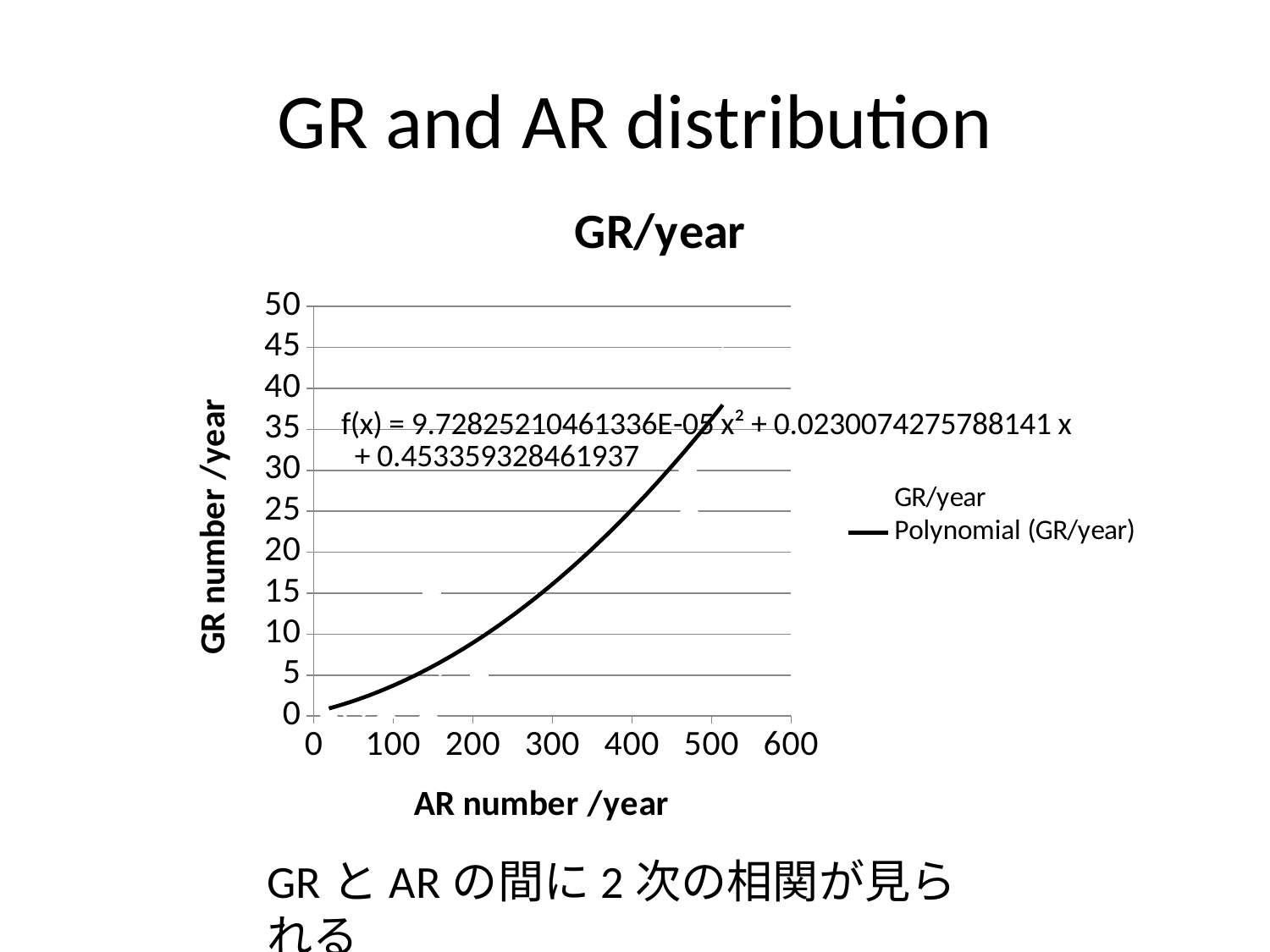
What kind of chart is shown on the slide? scatter chart Is the value of the polynomial trendline at AR number 100 greater or less than 5? less Is the value of the polynomial trendline at AR number 500 greater or less than 40? less What is the title of the chart? GR/year What is the highest value shown on the horizontal axis? 600 Does the polynomial trendline rise or fall as AR number /year increases? rises How many entries does the chart legend list? 2 Is the value of the polynomial trendline at AR number 300 greater or less than 20? less What is the highest value shown on the vertical axis? 50 What is the label of the vertical axis? GR number /year